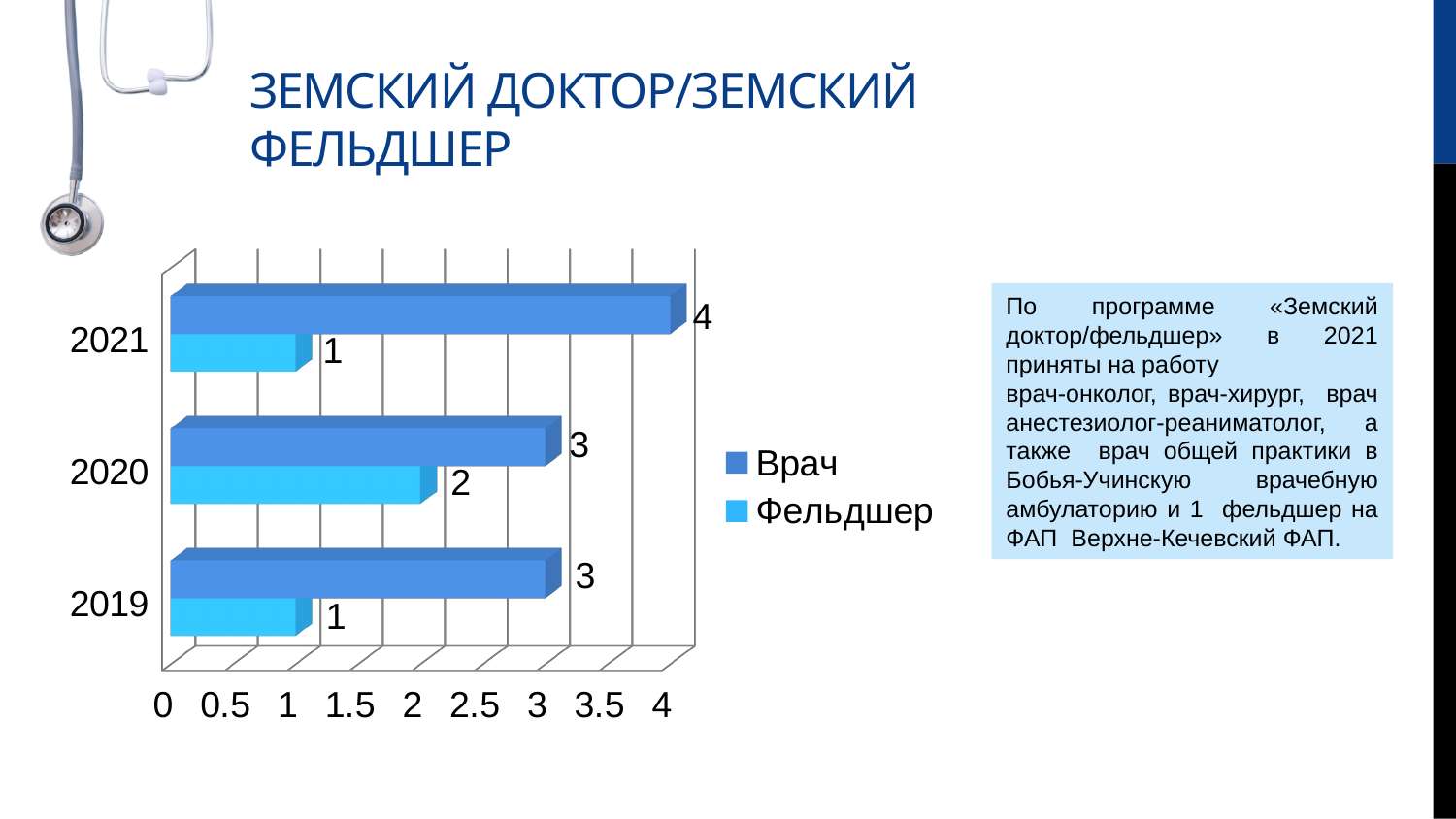
What is the value for Фельдшер in 2020? 2 What is the value for Врач in 2019? 3 What kind of chart is shown on the slide? Bar chart What is the value for Врач in 2021? 4 What is the value for Фельдшер in 2019? 1 In which year is the value for Фельдшер highest? 2020 In which year is the value for Врач highest? 2021 What is the difference between Врач and Фельдшер in 2021? 3 How many years are shown on the chart? 3 Which series is shown in light blue in the legend? Фельдшер How many series does the legend list? 2 Which is larger in 2020, Врач or Фельдшер? Врач